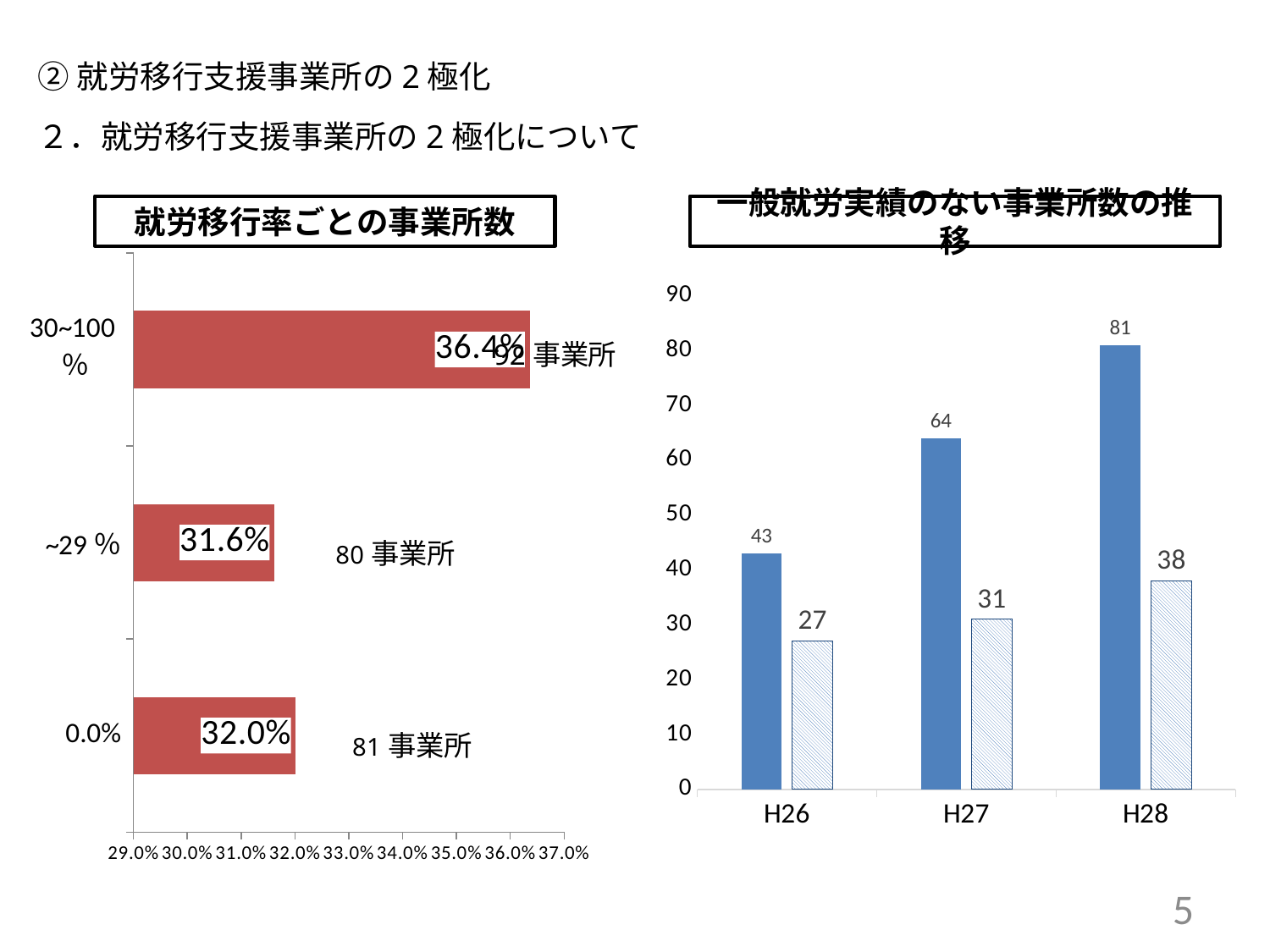
In the chart titled 一般就労実績のない事業所数の推移, what is the value of the solid blue bar for H27? 64 In the chart titled 一般就労実績のない事業所数の推移, how many years are shown on the x axis? 3 In the chart titled 一般就労実績のない事業所数の推移, which year has the lowest hatched bar value? H26 In the chart titled 就労移行率ごとの事業所数, how many categories are plotted? 3 In the chart titled 就労移行率ごとの事業所数, how many 事業所 are shown for the 0.0% category? 81 事業所 What kind of chart is the one titled 就労移行率ごとの事業所数? Bar chart In the chart titled 一般就労実績のない事業所数の推移, what is the value of the hatched bar for H28? 38 In the chart titled 就労移行率ごとの事業所数, what is the percentage shown for the ~29% category? 31.6% In the chart titled 就労移行率ごとの事業所数, what is the percentage shown for the 30~100% category? 36.4% In the chart titled 一般就労実績のない事業所数の推移, what is the difference between the solid blue bar and the hatched bar for H26? 16 In the chart titled 就労移行率ごとの事業所数, which category has the highest percentage? 30~100% In the chart titled 一般就労実績のない事業所数の推移, do the solid blue bar values rise or fall from H26 to H28? Rise